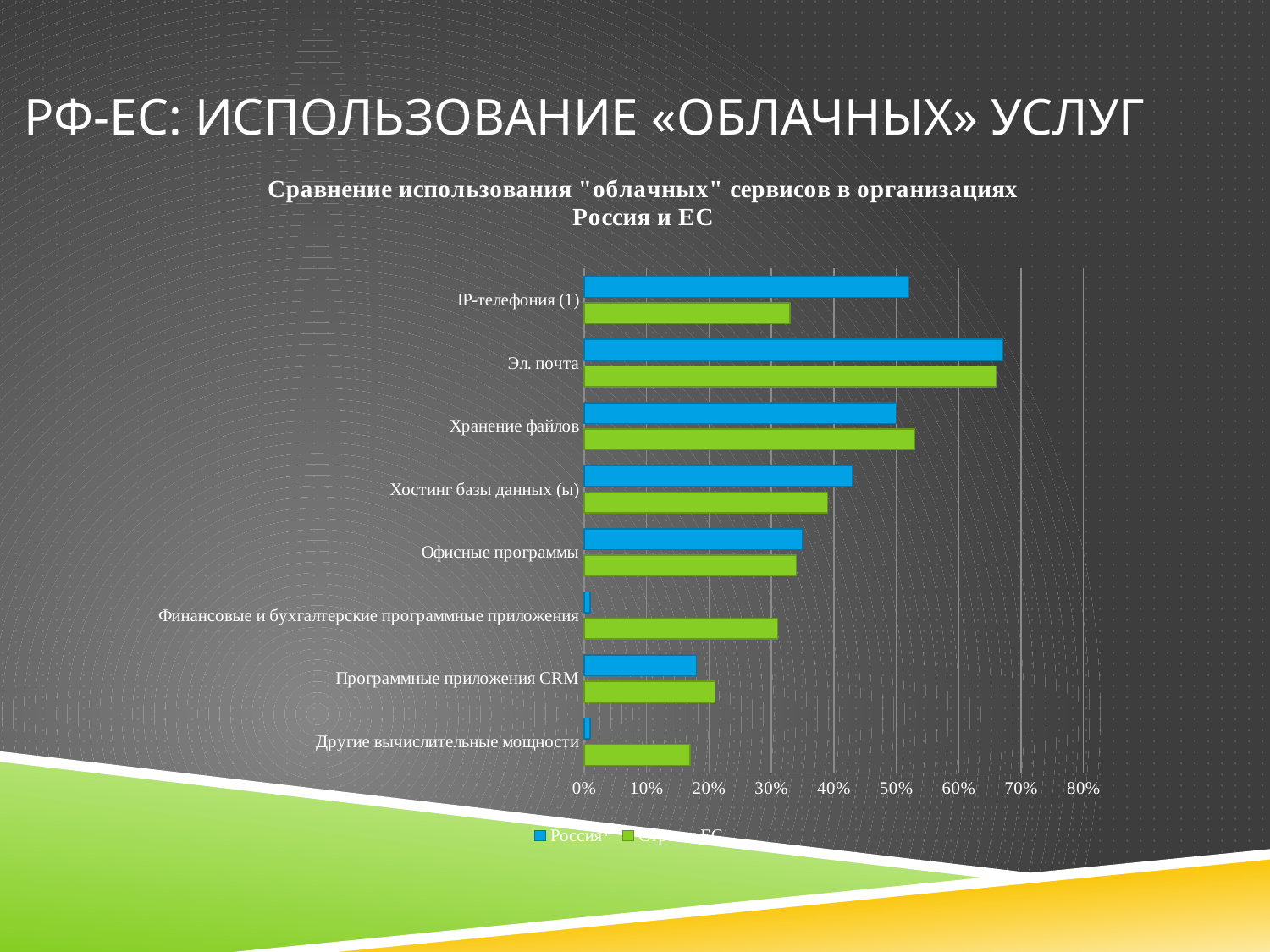
Which category has the highest value for the Россия series? Эл. почта For Финансовые и бухгалтерские программные приложения, which series has the larger value: Россия or the EU series? the EU series Is the Россия value for Финансовые и бухгалтерские программные приложения greater or less than 10%? less How many series does the chart's legend list? 2 Is the Россия value for Хостинг базы данных (ы) greater or less than 30%? greater Is the Россия value for IP-телефония (1) greater or less than 40%? greater What colour are the bars for the Россия series? blue What kind of chart is shown on the slide? bar chart For IP-телефония (1), which series has the larger value: Россия or the EU series? Россия How many categories (services) are plotted on the chart? 8 What is the title of the chart? Сравнение использования "облачных" сервисов в организациях Россия и ЕС